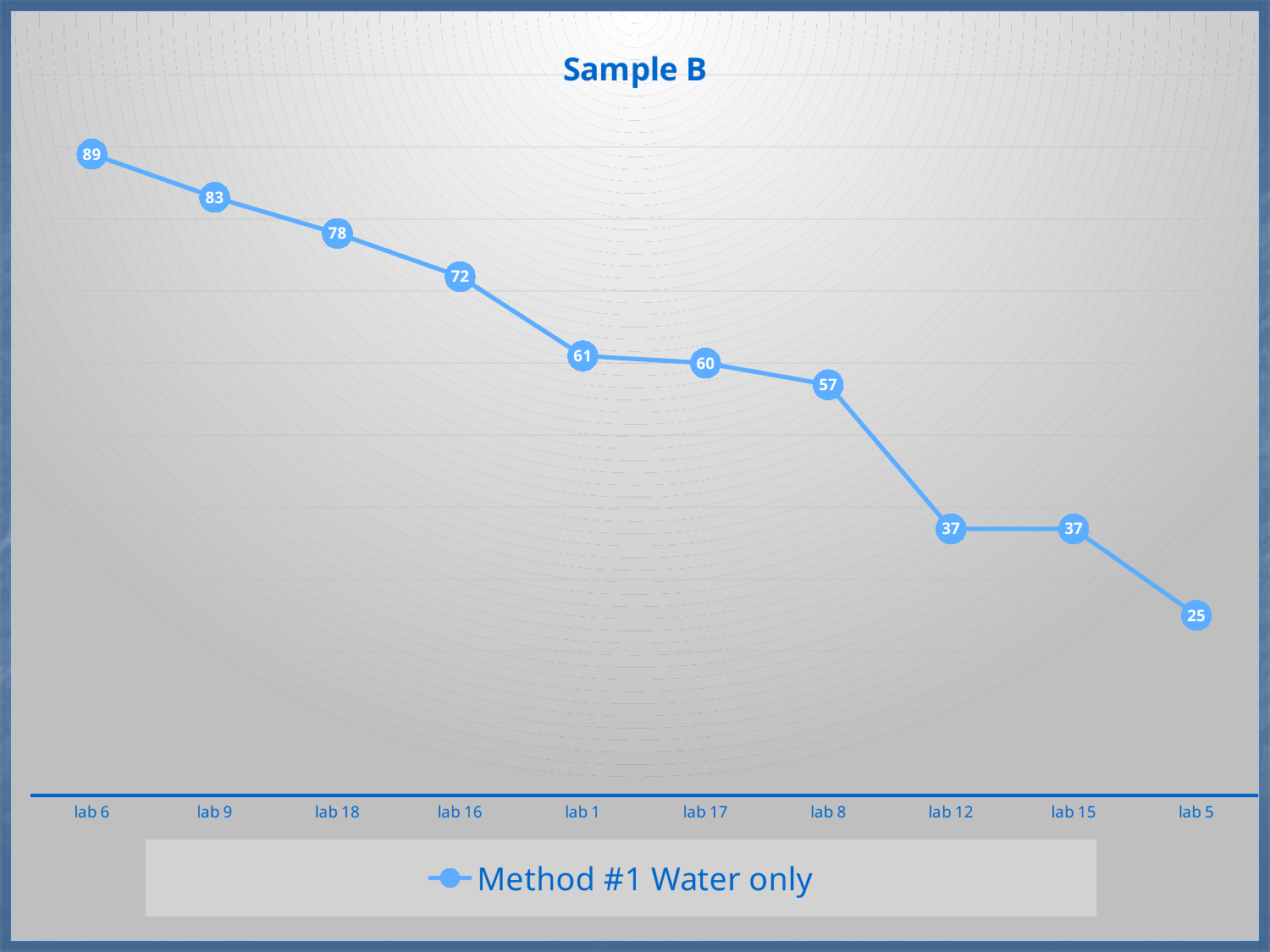
What is the value for lab 1? 61 What kind of chart is shown? line chart Do the values rise or fall from left to right along the x axis? fall What is the difference between the values for lab 8 and lab 12? 20 What is the difference between the values for lab 6 and lab 5? 64 How many series does the legend list? 1 How many labs are plotted on the chart? 10 Which lab has the lowest value? lab 5 What is the value for lab 5? 25 Which lab has the highest value? lab 6 Which has a larger value, lab 9 or lab 17? lab 9 What is the value for lab 6? 89